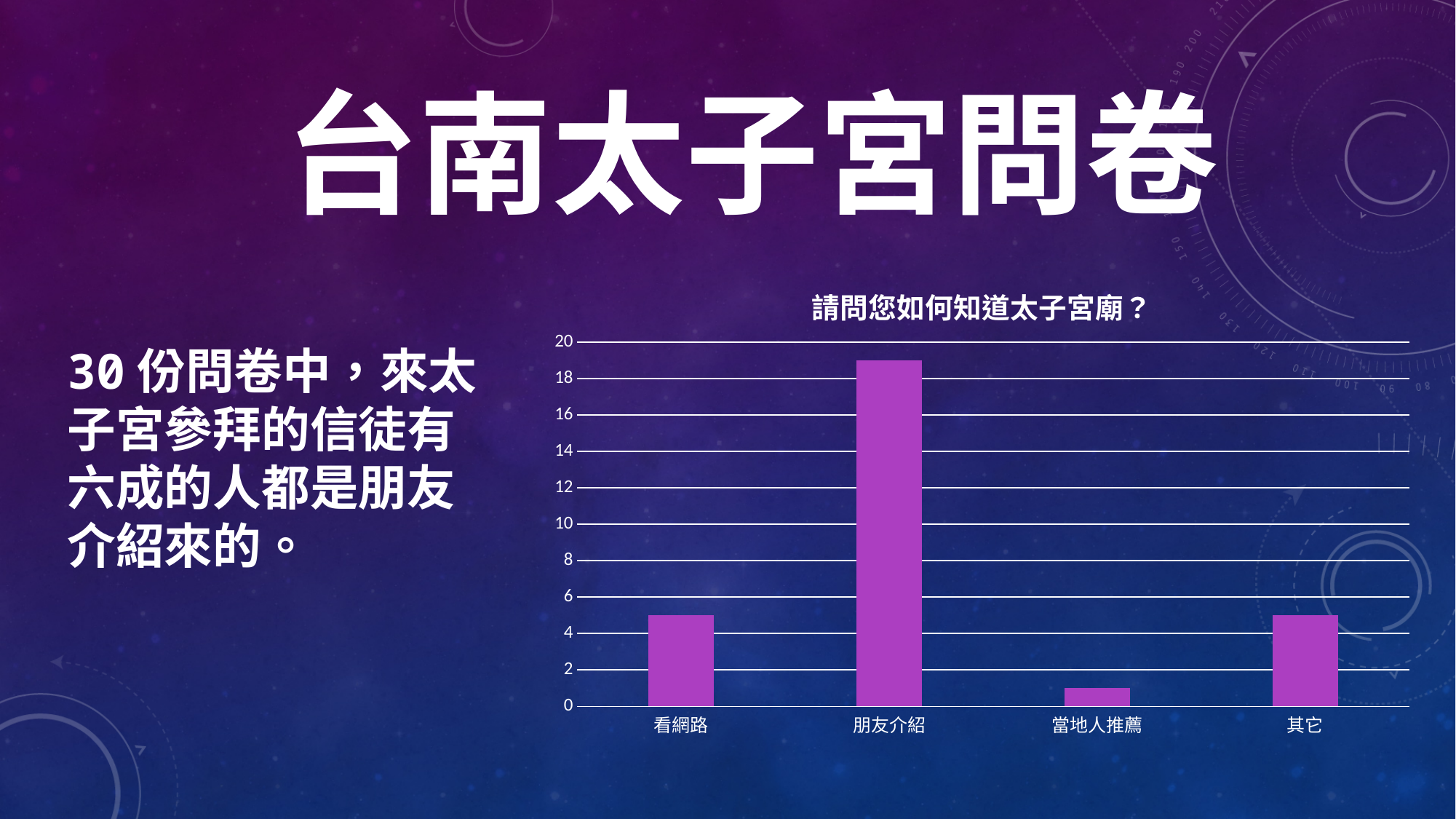
Which is larger, the value for 朋友介紹 or the value for 看網路? 朋友介紹 Which category has the highest bar in the chart? 朋友介紹 How many categories are shown on the x axis of the chart? 4 Is the value for 看網路 greater or less than 10? less Is the value for 朋友介紹 greater or less than 10? greater Is the value for 朋友介紹 greater or less than 18? greater What type of chart is shown on the slide? bar chart Which category has the lowest bar in the chart? 當地人推薦 What is the title of the chart? 請問您如何知道太子宮廟？ What colour are the bars in the chart? purple